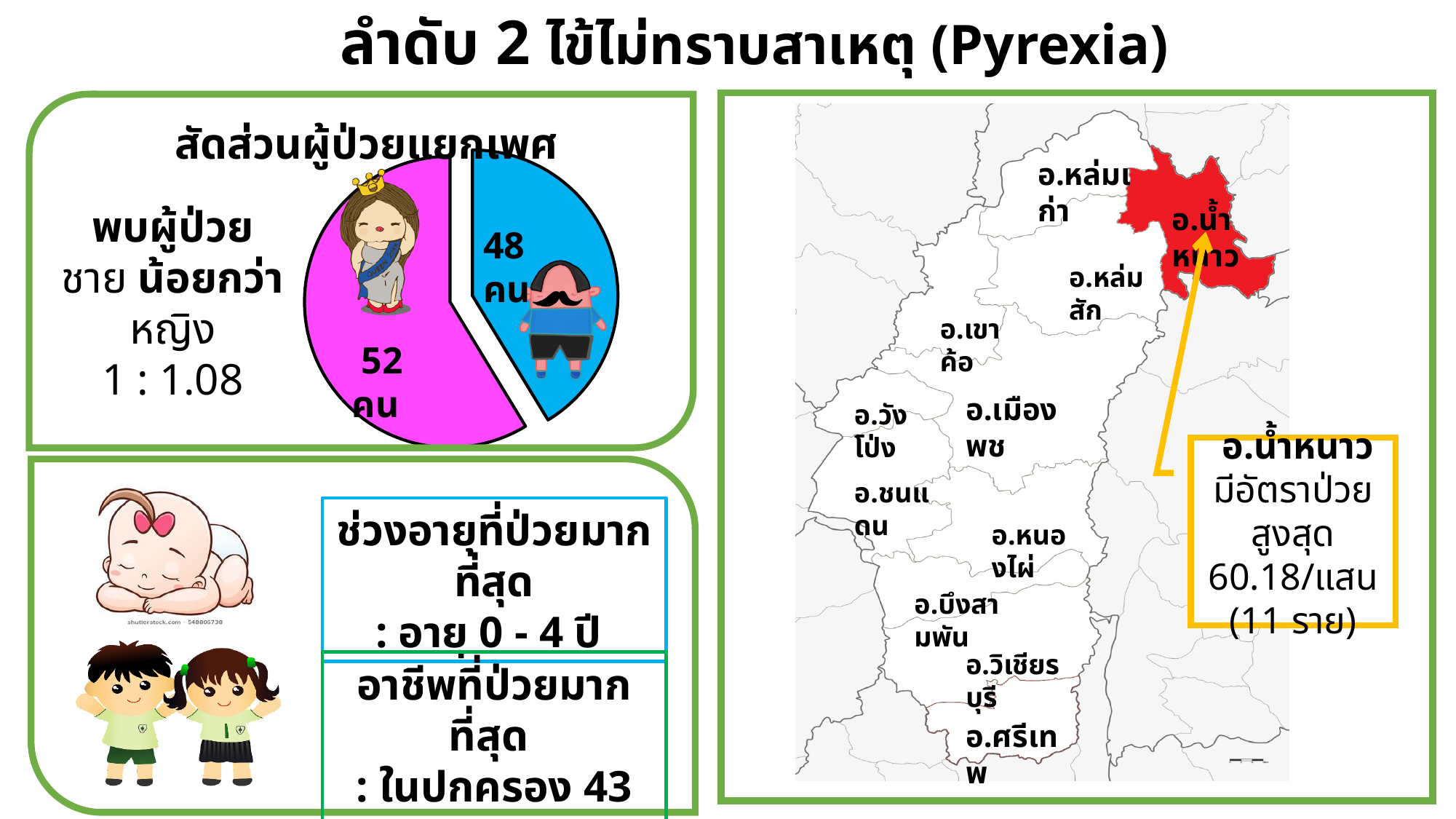
What is the difference between the female and male values in the pie chart? 4 คน What is the title of the pie chart? สัดส่วนผู้ป่วยแยกเพศ What share of the pie chart does the male (48 คน) slice represent? 48% What share of the pie chart does the female (52 คน) slice represent? 52% How many slices does the pie chart have? 2 What kind of chart is shown in the top-left panel of the slide? pie chart In the pie chart, what value is shown on the pink (female) slice? 52 คน Which slice of the pie chart is the smallest? blue (male), 48 คน In the pie chart, what value is shown on the blue (male) slice? 48 คน What is the total of the two slices in the pie chart? 100 คน Which slice of the pie chart is larger, the pink (female) slice or the blue (male) slice? pink (female) What colour is the slice representing male patients in the pie chart? blue